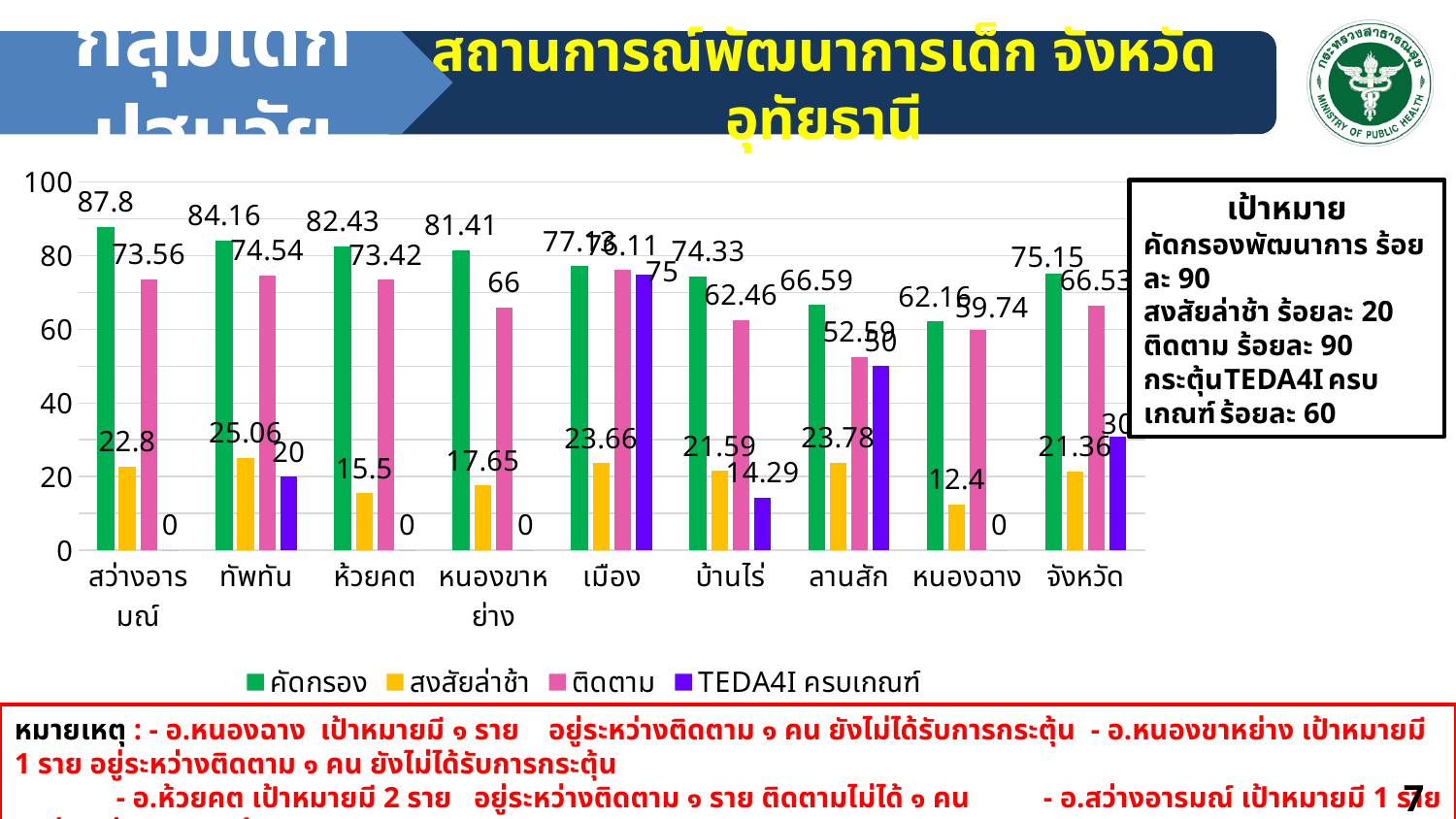
From สว่างอารมณ์ to หนองฉาง, do the คัดกรอง values rise or fall along the x axis? fall What colour represents the คัดกรอง series in the legend? green Which category has the lowest คัดกรอง value? หนองฉาง Which category has the highest คัดกรอง value? สว่างอารมณ์ How many categories are shown along the x axis? 9 What is the คัดกรอง value for สว่างอารมณ์? 87.8 What kind of chart is shown on the slide? bar chart What is the สงสัยล่าช้า value for หนองฉาง? 12.4 How many series does the legend list? 4 What is the difference between the คัดกรอง values for สว่างอารมณ์ and ทัพทัน? 3.64 What is the TEDA4I ครบเกณฑ์ value for เมือง? 75 Which has the larger ติดตาม value, หนองขาหย่าง or บ้านไร่? หนองขาหย่าง